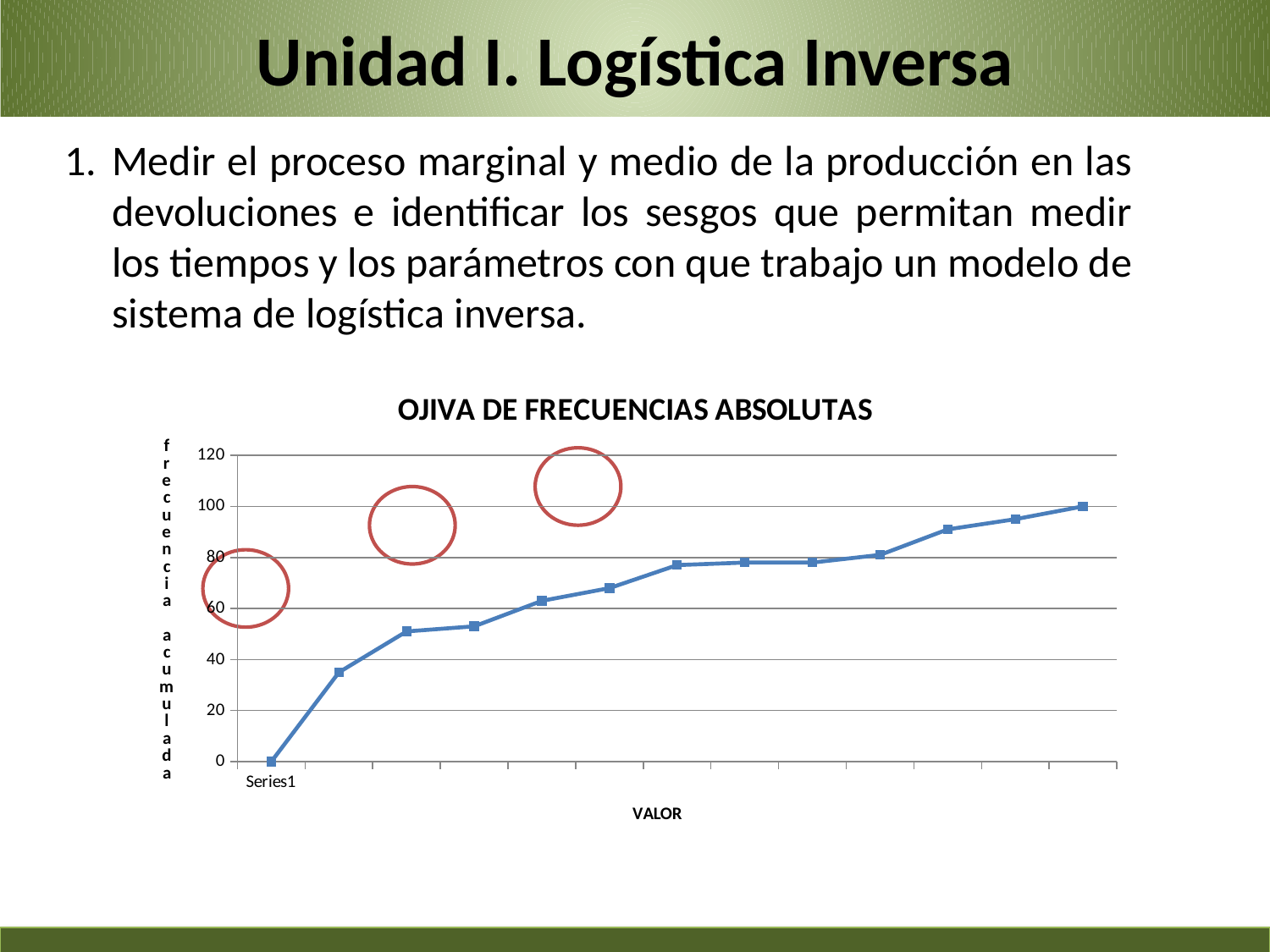
What is the value of the first (leftmost) point on the line? 0 Which is larger, the value of the second point from the left or the value of the rightmost point? the rightmost point How many lines (series) are plotted on the chart? 1 Do the plotted values rise or fall from left to right along the x axis? rise Is the value of the last (rightmost) point greater or less than 80? greater What is the title of the chart? OJIVA DE FRECUENCIAS ABSOLUTAS What kind of chart is shown on the slide? line chart What is the label of the horizontal axis of the chart? VALOR Which point on the line has the highest value, the leftmost or the rightmost? the rightmost How many data points are plotted on the line? 13 Is the value of the fifth point from the left greater or less than 80? less Is the value of the second point from the left greater or less than 20? greater